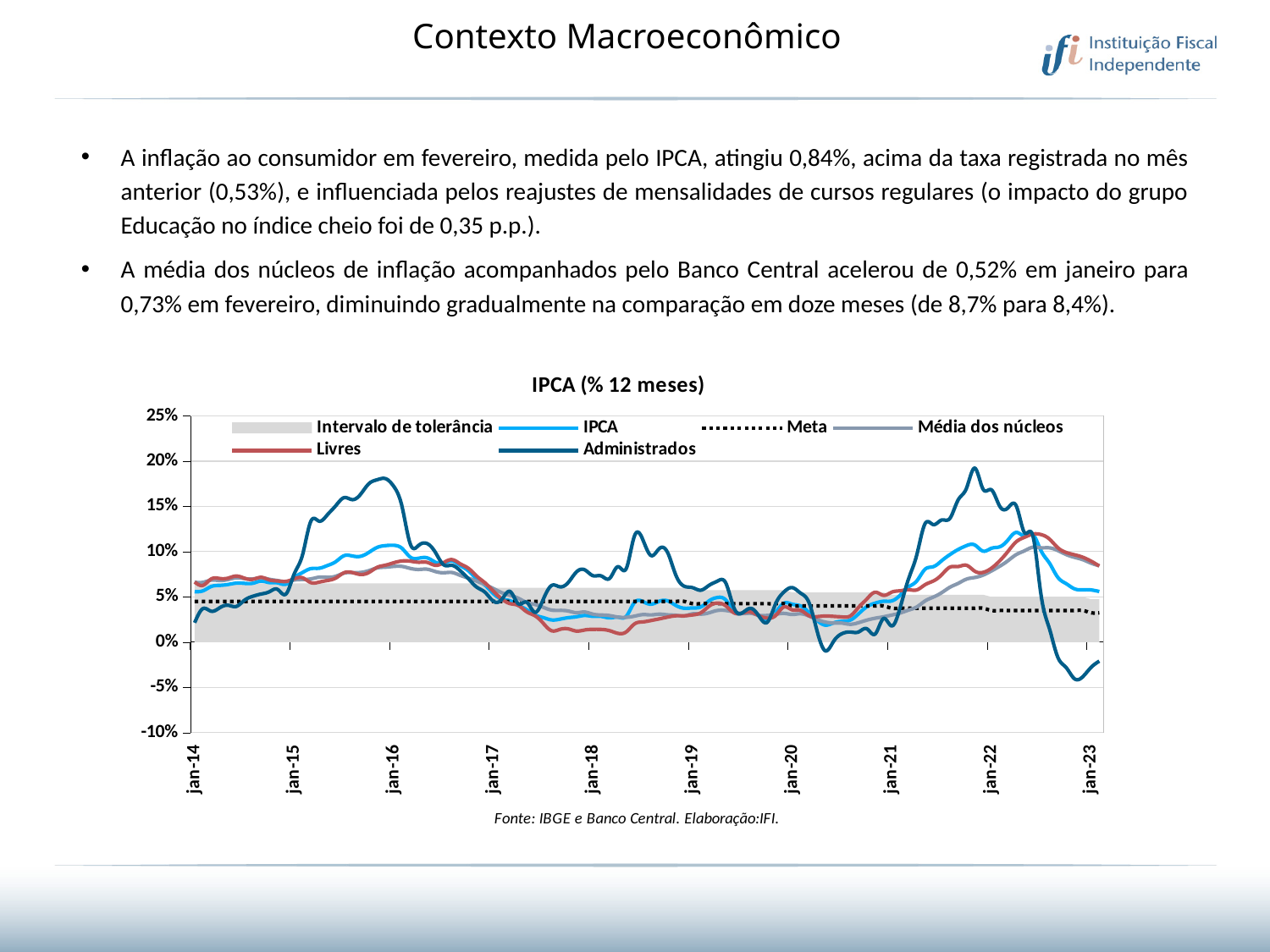
What kind of chart is shown on the slide? Line chart Which series reaches the highest value anywhere on the chart? Administrados Is the value of Administrados at jan-23 greater or less than 0%? less Is the value of Administrados at jan-16 greater or less than 15%? greater How many entries does the chart legend list? 6 Which series reaches the lowest value anywhere on the chart? Administrados At jan-16, which is larger: Administrados or IPCA? Administrados How many year labels are shown on the x axis of the chart? 10 Does the Administrados series rise or fall between jan-22 and jan-23? Fall Is the value of Administrados at jan-22 greater or less than 10%? greater What is the title of the chart? IPCA (% 12 meses) At jan-23, which is larger: IPCA or Administrados? IPCA